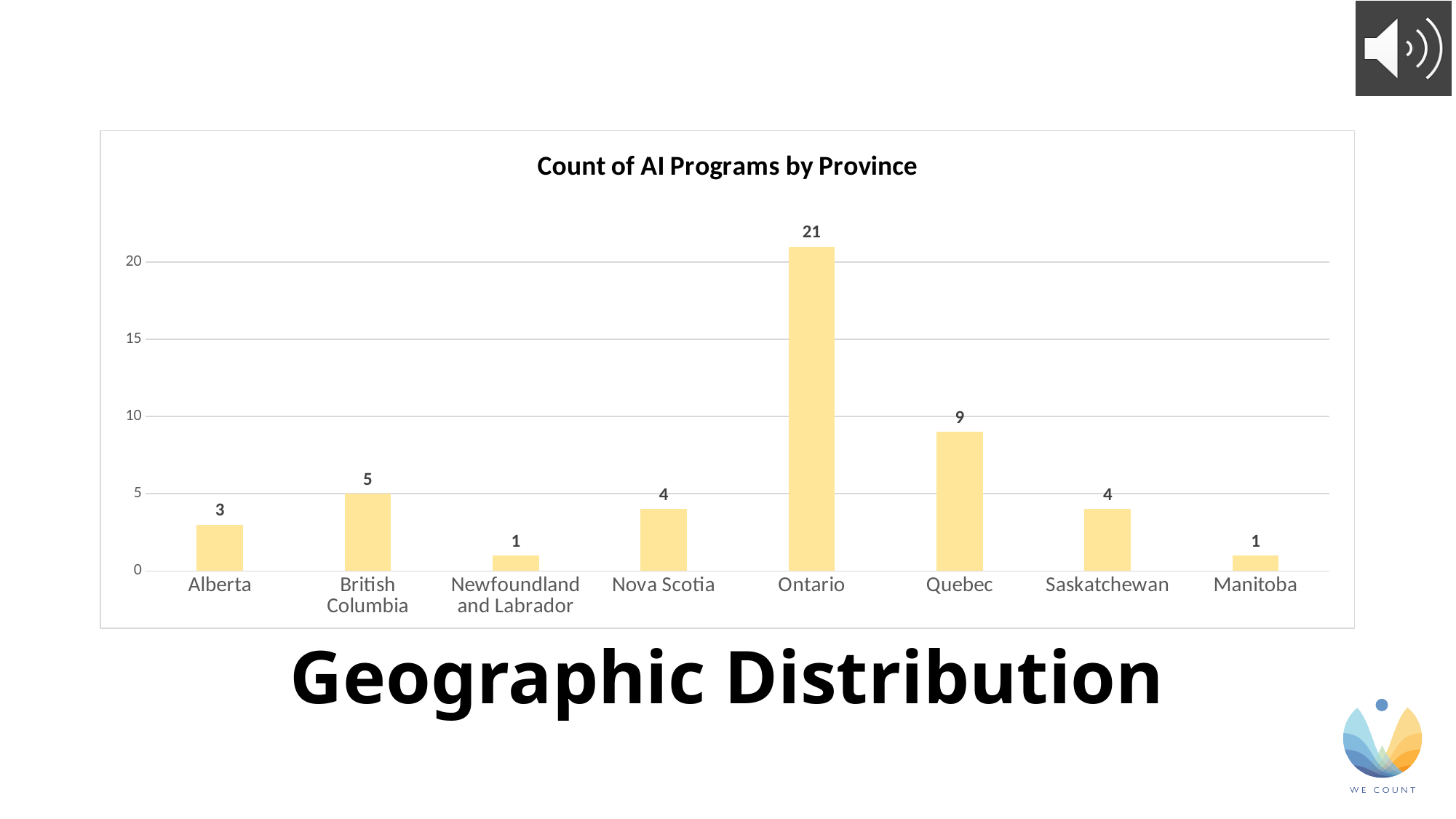
Is the value for Quebec greater or less than 10? less What kind of chart is shown on the slide? Bar chart Which has a higher count of AI programs, Alberta or Nova Scotia? Nova Scotia What is the difference between the counts for Ontario and Quebec? 12 Which province has the highest count of AI programs? Ontario What is the count of AI programs for British Columbia? 5 What is the count of AI programs for Ontario? 21 Which provinces have the lowest count of AI programs? Newfoundland and Labrador and Manitoba What is the title of the chart? Count of AI Programs by Province What is the count of AI programs for Quebec? 9 What is the difference between the counts for Saskatchewan and Manitoba? 3 How many provinces are shown on the chart? 8